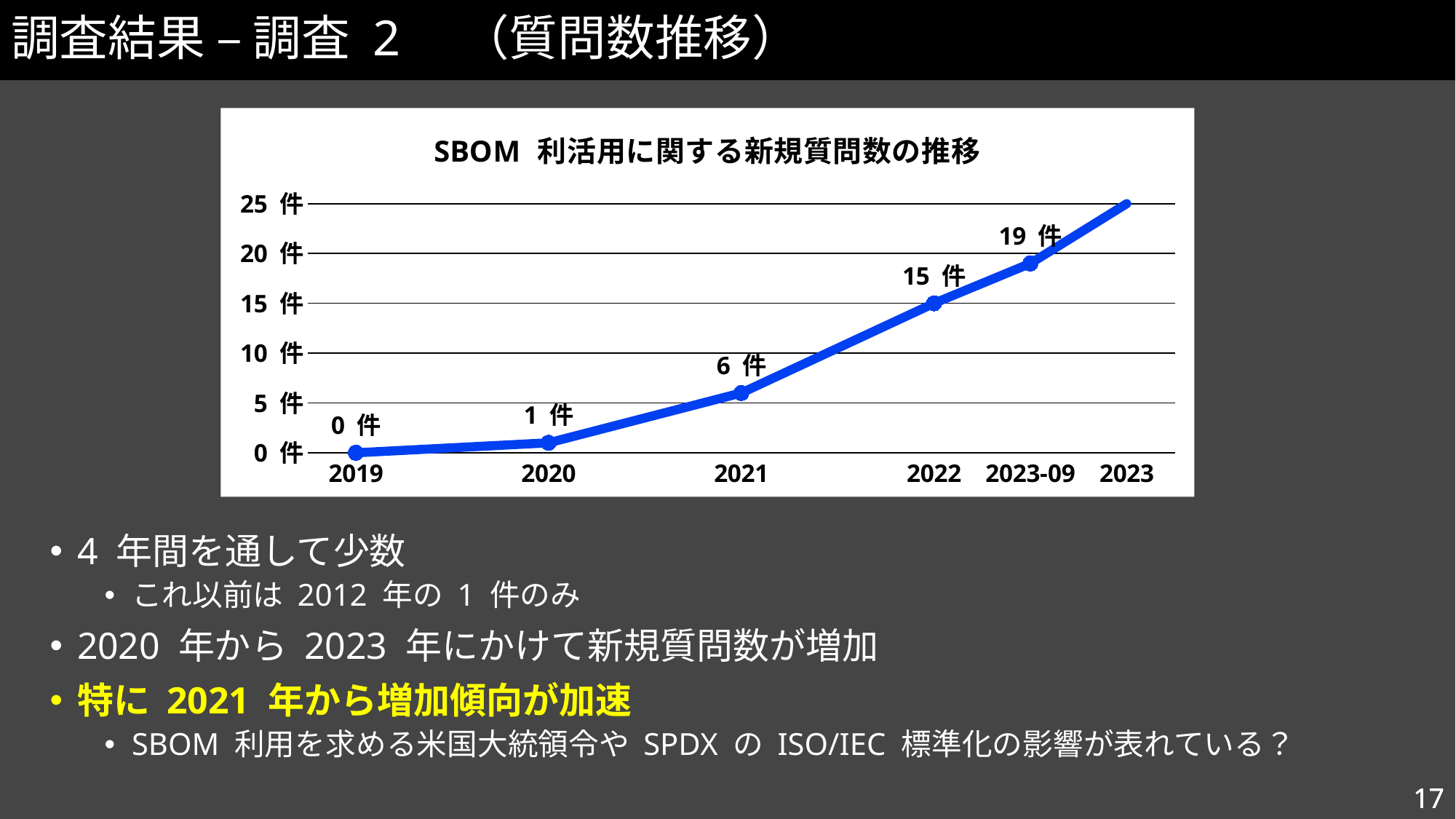
What is the value for 2019? 0 件 What is the difference between the values for 2022 and 2021? 9 件 What is the value for 2023-09? 19 件 Which is larger, the value for 2023-09 or the value for 2022? 2023-09 Is the value for 2023 greater or less than 20 件? greater What kind of chart is shown on the slide? line chart How many data points are plotted on the chart? 6 What is the value for 2022? 15 件 Which year has the lowest value? 2019 What is the value for 2020? 1 件 What is the value for 2021? 6 件 What is the title of the chart? SBOM 利活用に関する新規質問数の推移